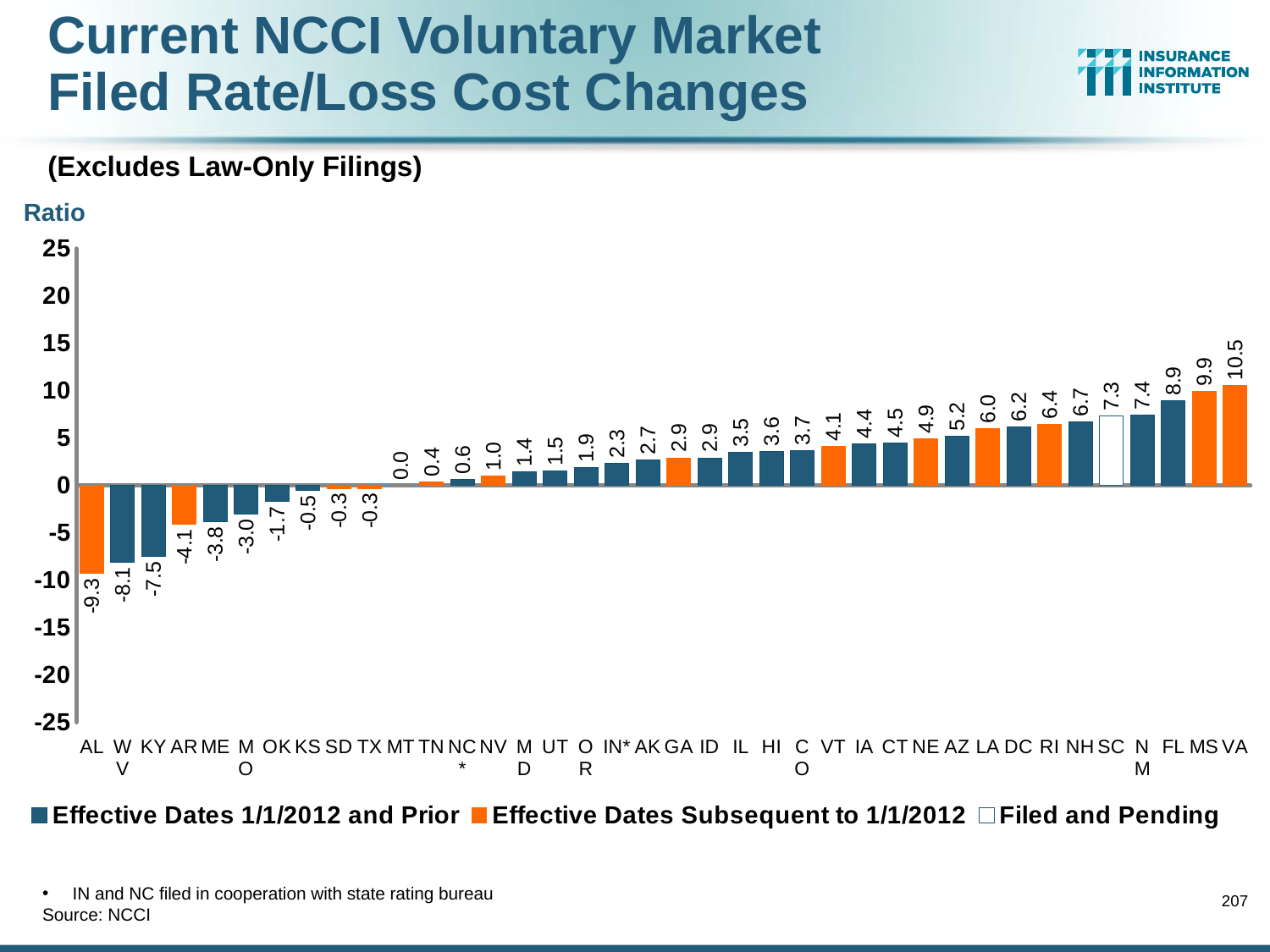
Which state has the highest value? VA Is the value for KY greater or less than -5? less What is the value for MT? 0.0 What is the value for AL? -9.3 Which state's bar is shown as Filed and Pending? SC What is the difference between the values for VA and AL? 19.8 Which state has the lowest value? AL How many series does the legend list? 3 What is the value for VA? 10.5 What kind of chart is this? bar chart How many states are shown on the chart? 38 Which has a larger value, FL or MS? MS